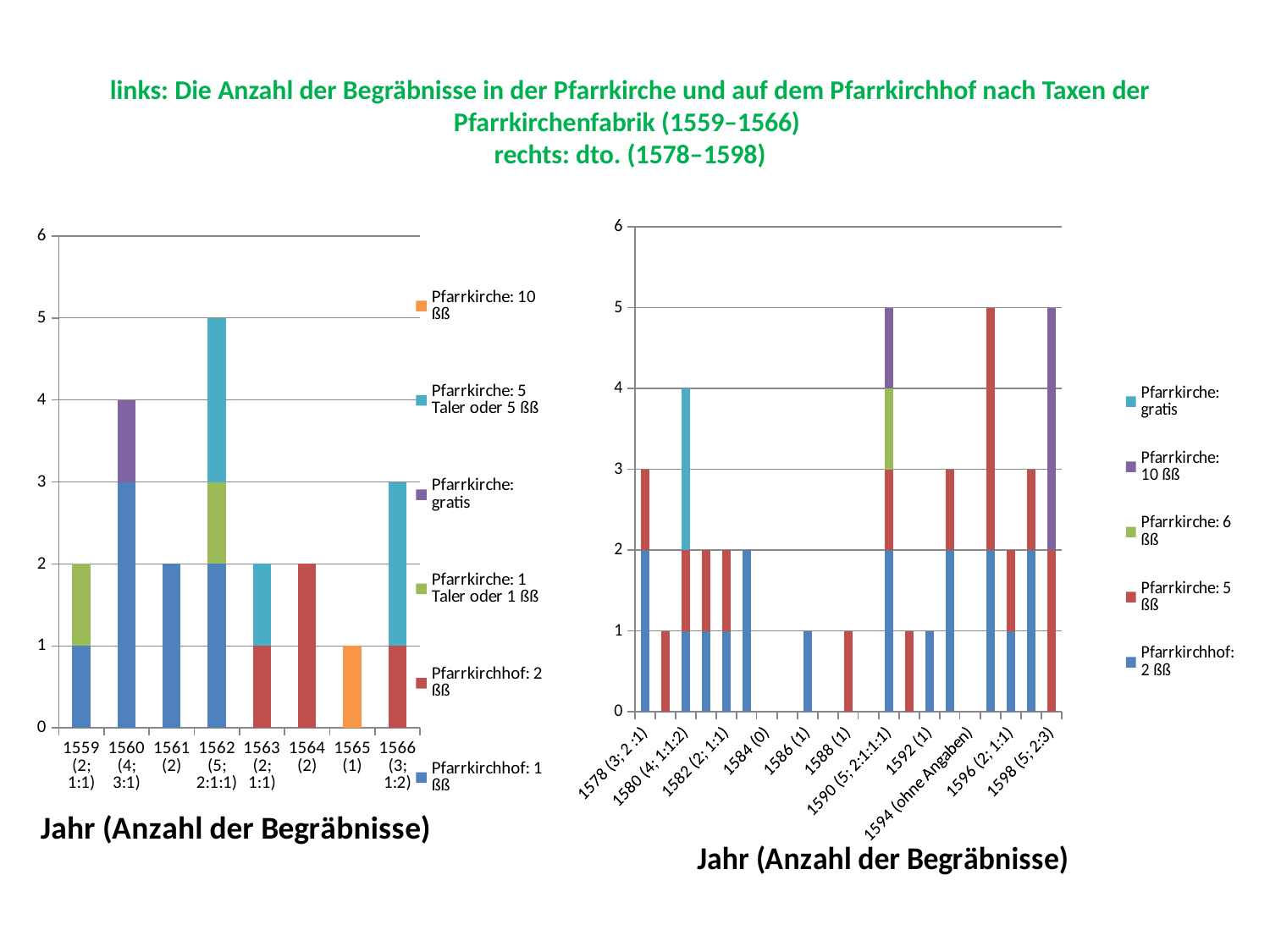
In the left chart (1559–1566), what is the total height of the stacked bar for 1560? 4 In the right chart (1578–1598), what is the total height of the stacked bar for 1590? 5 In the left chart (1559–1566), which year has the tallest stacked bar? 1562 What kind of chart is the left chart (1559–1566)? stacked bar chart How many series does the legend of the left chart (1559–1566) list? 6 How many series does the legend of the right chart (1578–1598) list? 5 In the left chart (1559–1566), what is the total height of the stacked bar for 1562? 5 In the left chart (1559–1566), which series is shown in orange? Pfarrkirche: 10 ßß In the left chart (1559–1566), is the total for 1565 larger or smaller than the total for 1566? smaller How many year categories are shown on the x axis of the left chart (1559–1566)? 8